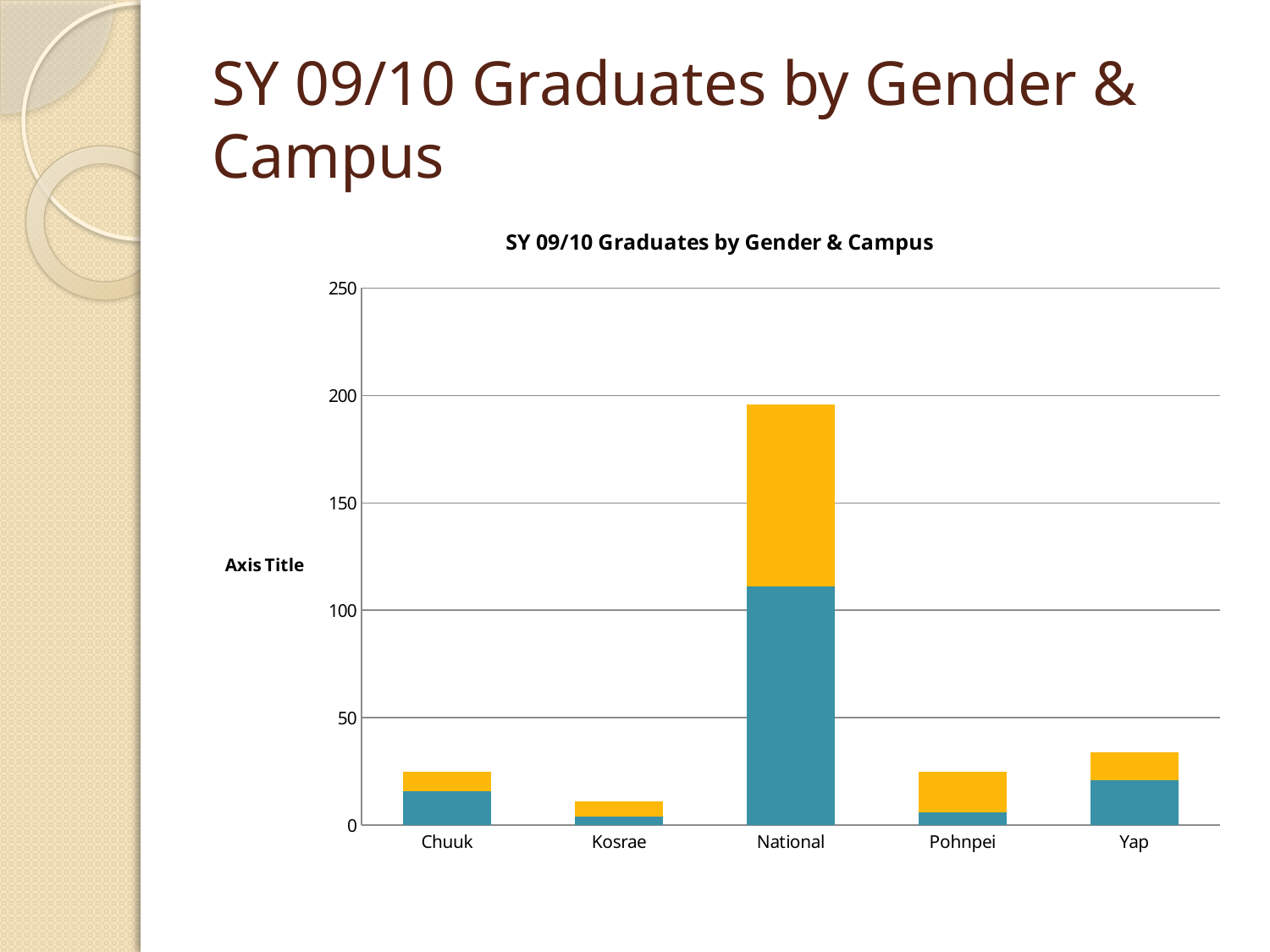
What label is shown on the vertical axis of the chart? Axis Title Is the total value for Kosrae greater or less than 50? less How many campus categories are shown on the x axis? 5 Which campus has the highest total bar? National Which has the larger total bar, Yap or Kosrae? Yap What is the title of the chart? SY 09/10 Graduates by Gender & Campus What kind of chart is shown on the slide? Stacked bar chart Which campus has the lowest total bar? Kosrae Is the total value for Yap greater or less than 50? less Which has the larger total bar, National or Yap? National Is the total value for National greater or less than 150? greater